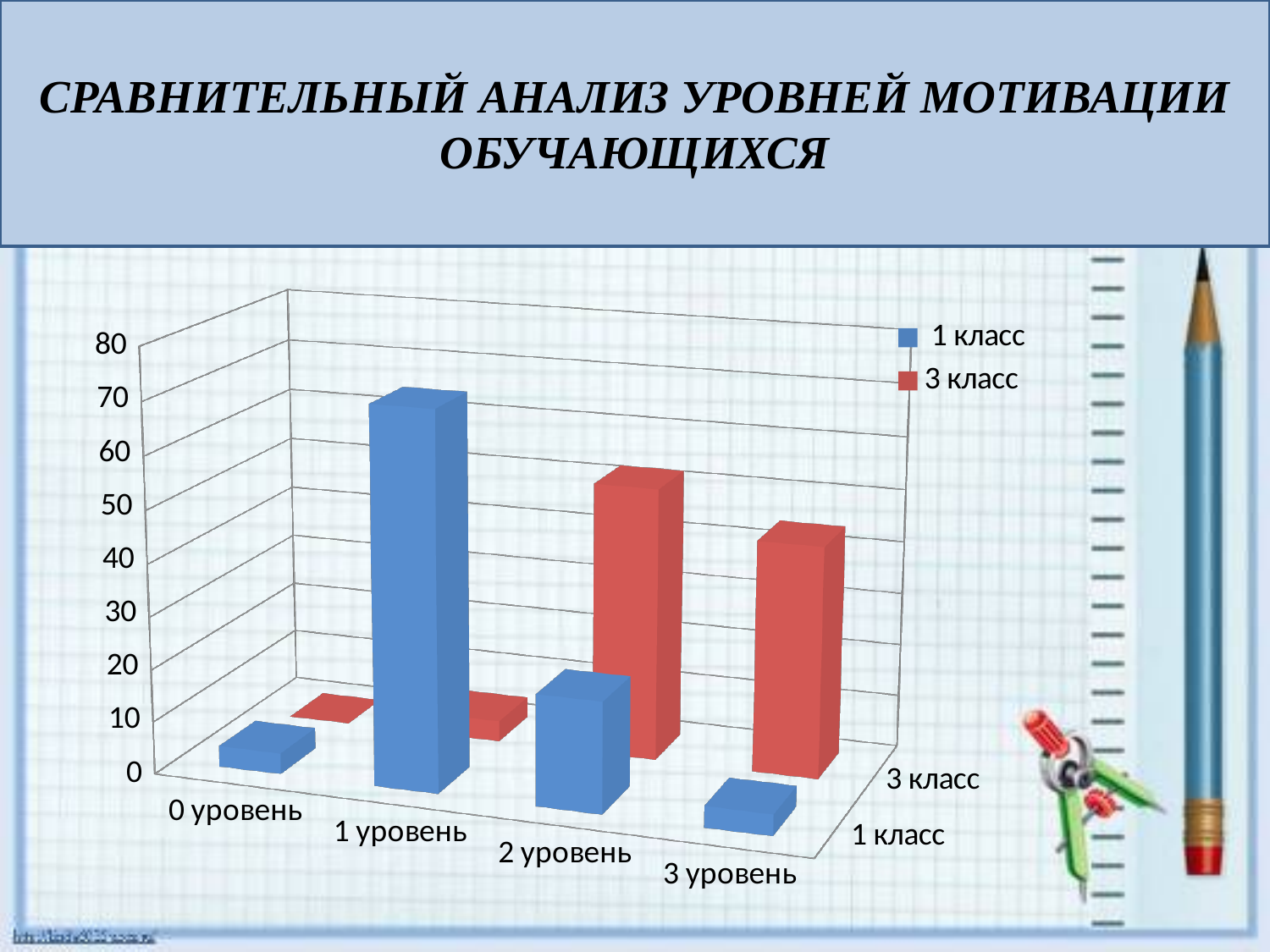
For the series 1 класс, which level has the highest value? 1 уровень At 1 уровень, which series has the larger value, 1 класс or 3 класс? 1 класс For the series 3 класс, which level has the highest value? 2 уровень At 2 уровень, which series has the larger value, 1 класс or 3 класс? 3 класс How many series does the legend list? 2 Is the value for 3 класс at 0 уровень greater or less than 20? less Is the value for 1 класс at 1 уровень greater or less than 50? greater Which series is shown in blue? 1 класс How many level categories are shown along the x axis? 4 Which series is shown in red? 3 класс What kind of chart is shown on the slide? bar chart At 3 уровень, which series has the larger value, 1 класс or 3 класс? 3 класс